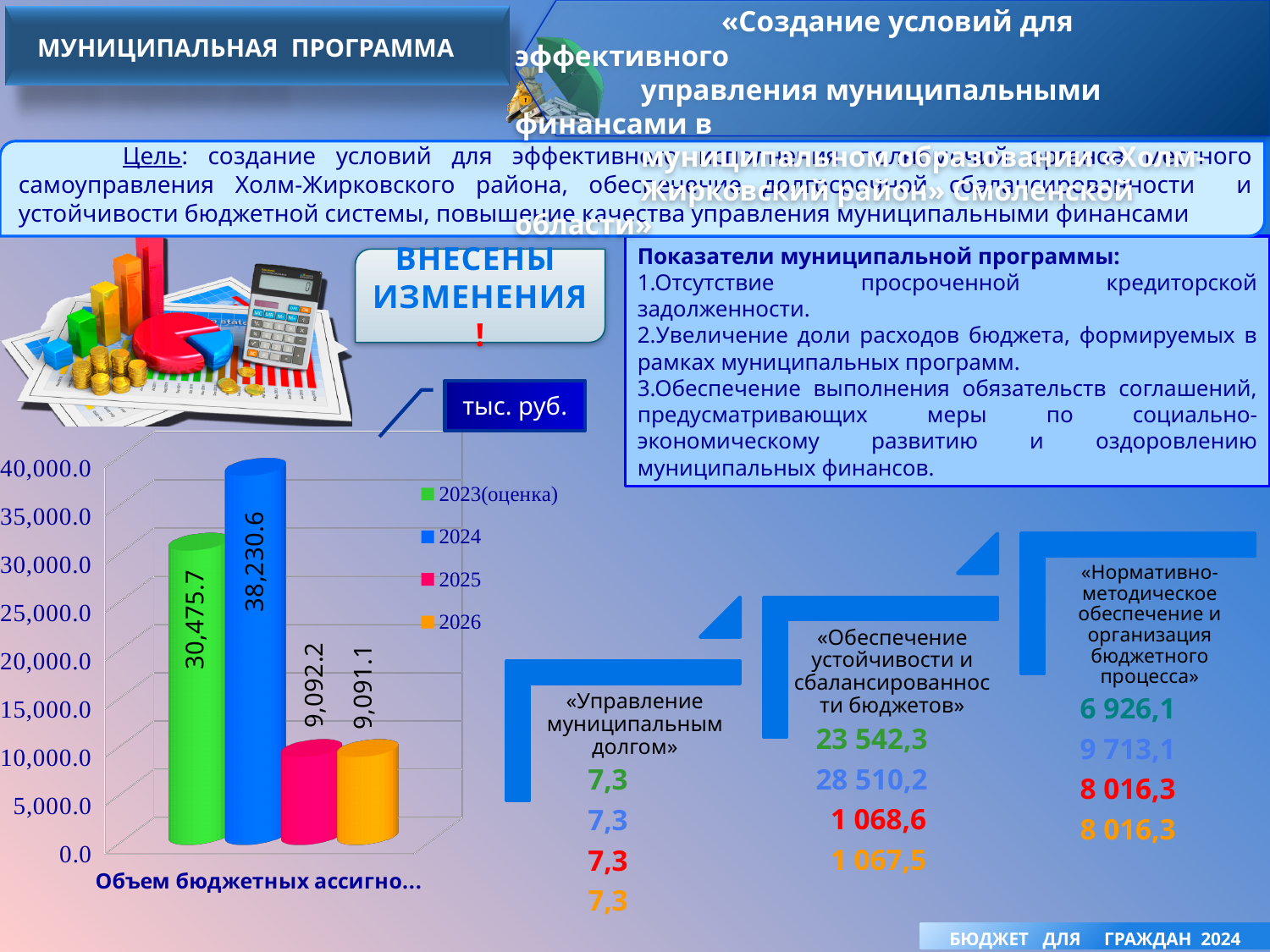
What is the value for 2025 in the bar chart? 9,092.2 What is the value for 2024 in the bar chart? 38,230.6 What is the value for 2023(оценка) in the bar chart? 30,475.7 Which year has the highest value in the bar chart? 2024 What kind of chart is shown on the slide? bar chart What unit is indicated for the values in the bar chart? тыс. руб. Is the value for 2025 in the bar chart greater or less than 10,000.0? less What is the difference between the 2024 and 2023(оценка) values in the bar chart? 7,754.9 Is the value for 2024 in the bar chart greater or less than 35,000.0? greater What is the value for 2026 in the bar chart? 9,091.1 How many series does the legend of the bar chart list? 4 Which is larger in the bar chart, the value for 2024 or the value for 2025? 2024